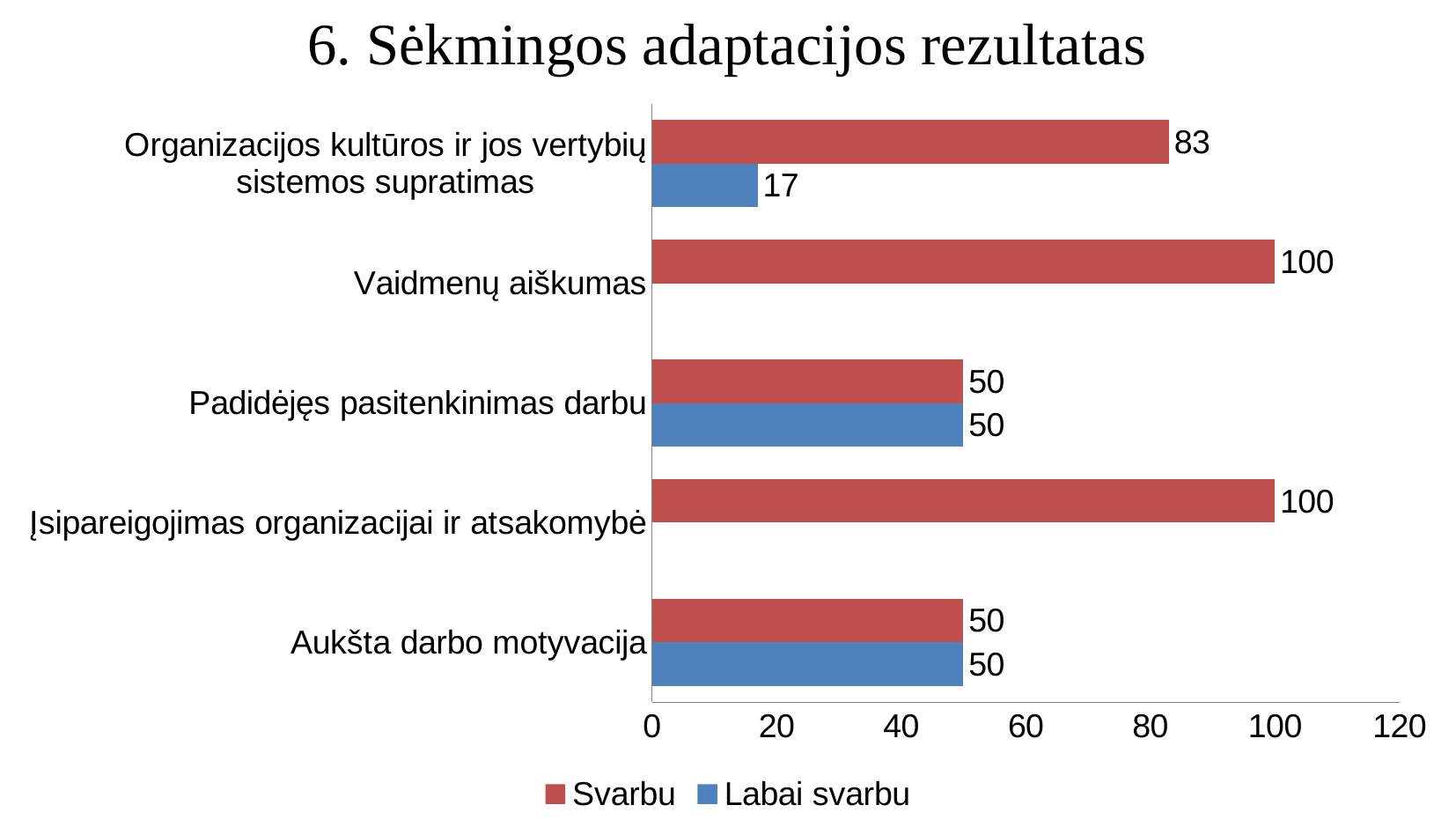
Which category has the lowest 'Svarbu' value? Aukšta darbo motyvacija and Padidėjęs pasitenkinimas darbu (both 50) How many categories are shown on the chart? 5 Which is larger for 'Organizacijos kultūros ir jos vertybių sistemos supratimas': the 'Svarbu' value or the 'Labai svarbu' value? Svarbu What kind of chart is shown on the slide? bar chart Is the 'Svarbu' value for 'Organizacijos kultūros ir jos vertybių sistemos supratimas' greater or less than 80? greater How many series does the legend list? 2 What is the 'Svarbu' value for 'Vaidmenų aiškumas'? 100 What is the 'Svarbu' value for 'Organizacijos kultūros ir jos vertybių sistemos supratimas'? 83 What is the 'Labai svarbu' value for 'Organizacijos kultūros ir jos vertybių sistemos supratimas'? 17 What is the difference between the 'Svarbu' and 'Labai svarbu' values for 'Organizacijos kultūros ir jos vertybių sistemos supratimas'? 66 What is the 'Labai svarbu' value for 'Padidėjęs pasitenkinimas darbu'? 50 What is the title of the chart? 6. Sėkmingos adaptacijos rezultatas